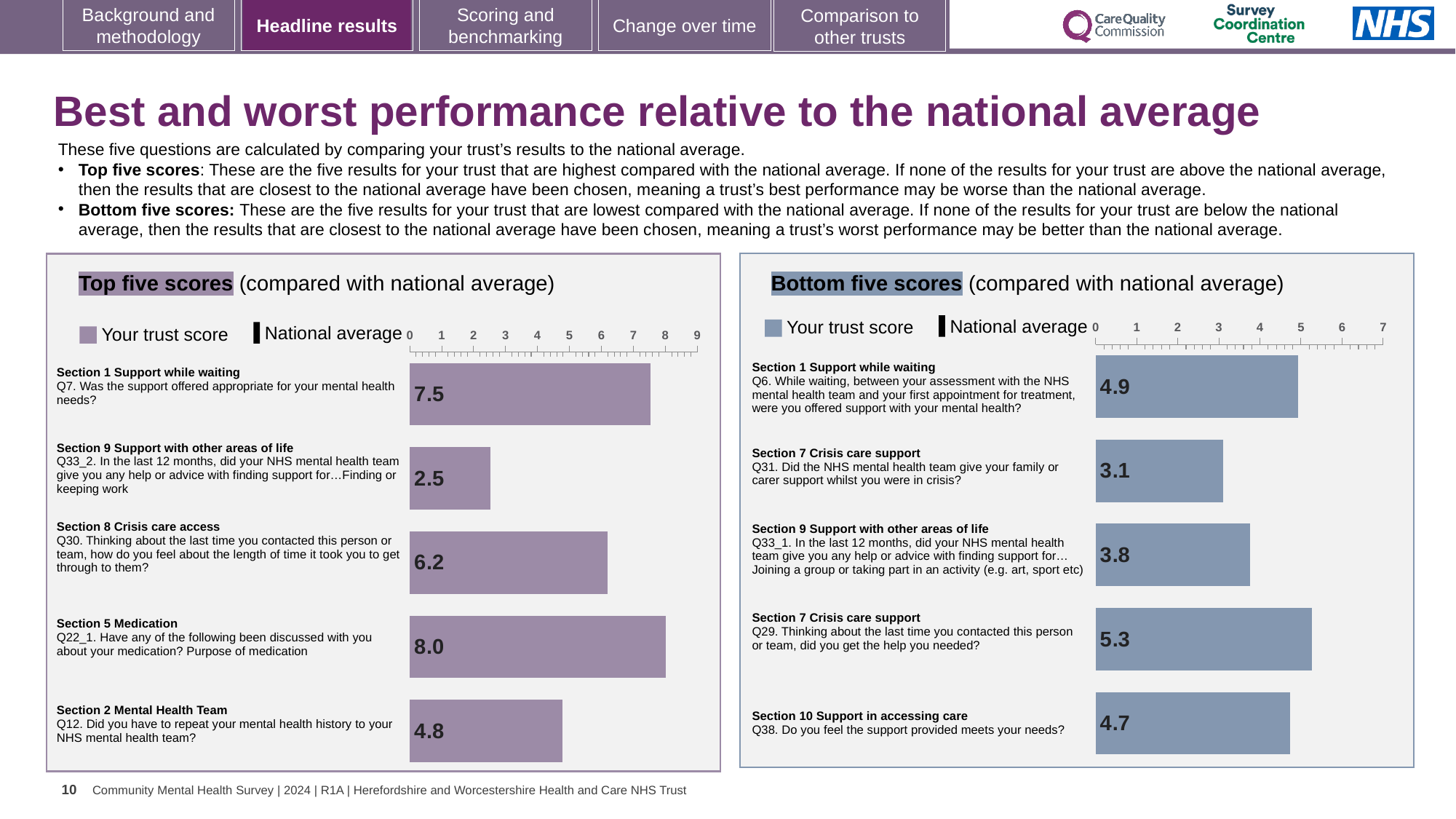
In the Top five scores chart, which question has the lowest trust score? Q33_2 (Finding or keeping work) In the Bottom five scores chart, what is the trust score for Q31 (Did the NHS mental health team give your family or carer support whilst you were in crisis?)? 3.1 In the Top five scores chart, what is the trust score for Q7 (Was the support offered appropriate for your mental health needs?)? 7.5 In the Top five scores chart, what is the difference between the trust scores for Q22_1 and Q30? 1.8 In the Top five scores chart, what is the trust score for Q12 (Did you have to repeat your mental health history to your NHS mental health team?)? 4.8 In the Bottom five scores chart, what is the trust score for Q38 (Do you feel the support provided meets your needs?)? 4.7 How many questions are plotted in the Bottom five scores chart? 5 In the Bottom five scores chart, which has the larger trust score, Q6 or Q38? Q6 In the Bottom five scores chart, what is the difference between the trust scores for Q6 and Q33_1? 1.1 In the Bottom five scores chart, which question has the highest trust score? Q29 (did you get the help you needed?) What kind of chart is the Top five scores chart? Bar chart In the Top five scores chart, which question has the highest trust score? Q22_1 (Purpose of medication)